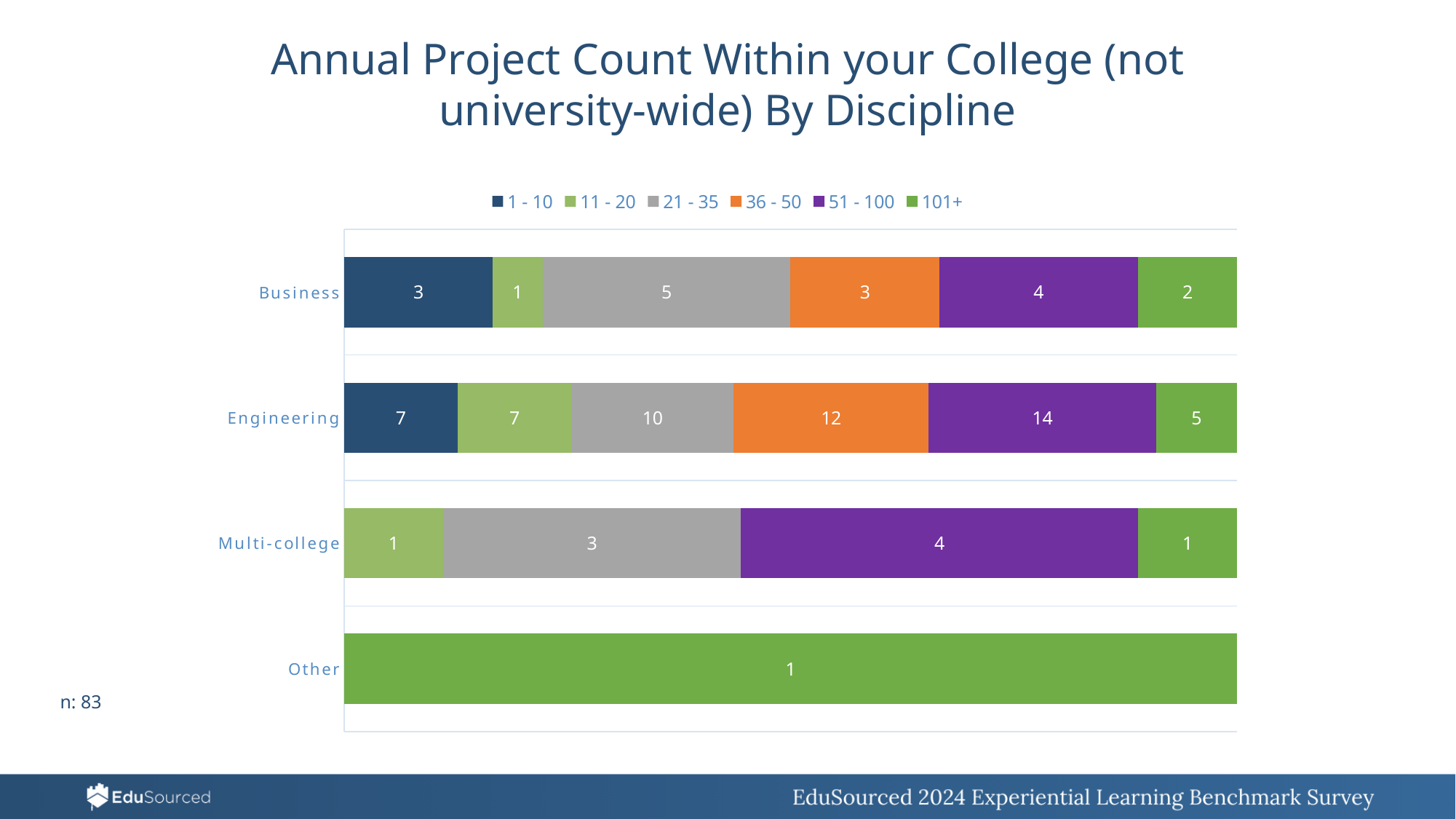
Which discipline has the highest value for the 36 - 50 series? Engineering What is the total of the Engineering bar? 55 What is the value for the 51 - 100 series in the Engineering bar? 14 What is the value for the 21 - 35 series in the Business bar? 5 What is the difference between the 51 - 100 value and the 1 - 10 value in the Engineering bar? 7 What sample size (n) is shown on the slide? 83 Which is larger: the 21 - 35 value for Business or the 21 - 35 value for Multi-college? Business How many series does the legend list? 6 How many discipline categories are shown on the chart? 4 What is the total of the Business bar? 18 What kind of chart is shown on the slide? Stacked bar chart What is the value for the 101+ series in the Multi-college bar? 1